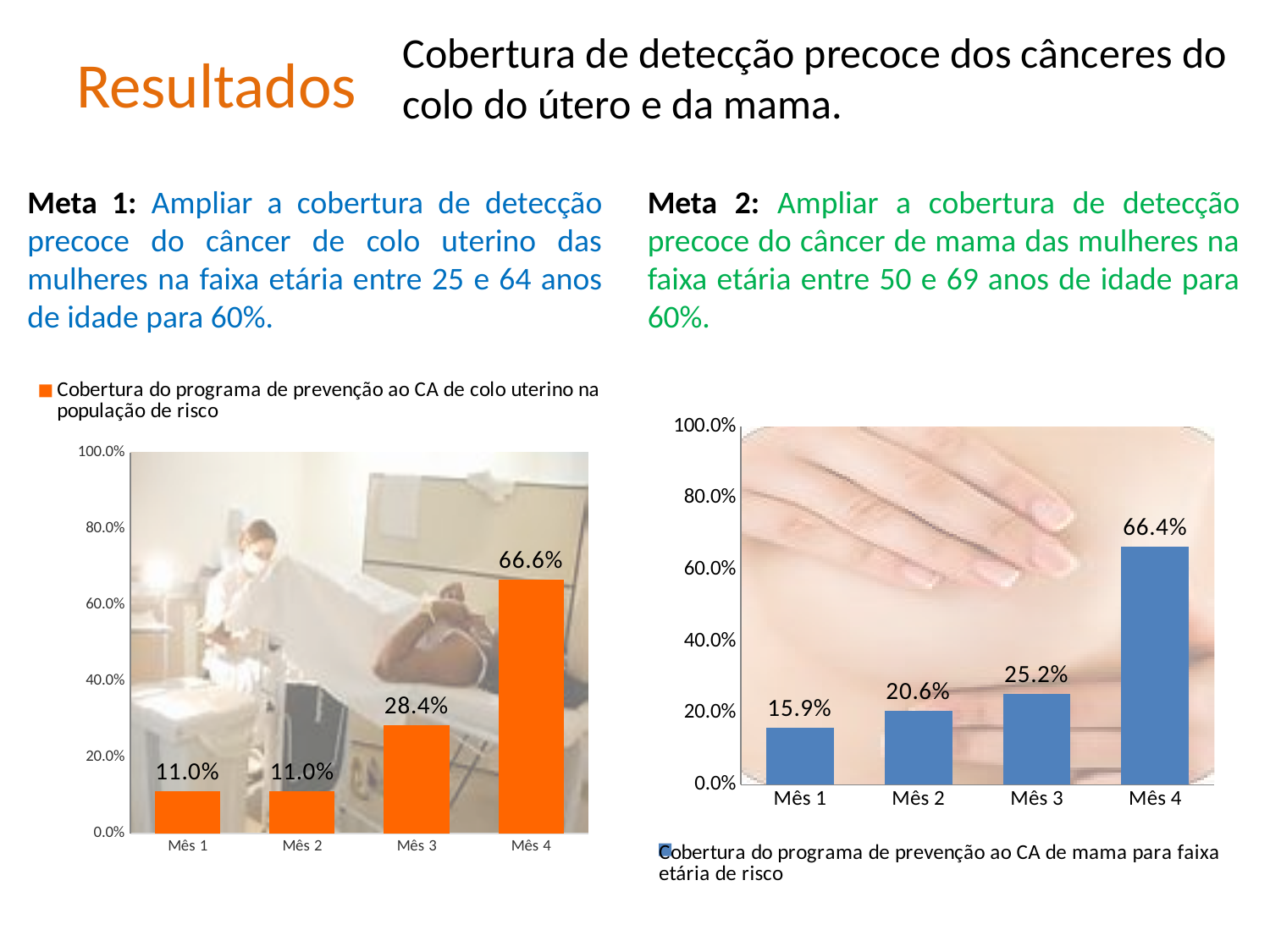
In the left chart (colo uterino), what is the value for Mês 4? 66.6% Which is larger: the Mês 4 value in the left chart (colo uterino) or the Mês 4 value in the right chart (mama)? Left chart (colo uterino), 66.6% How many months are shown on the x axis of the left chart (colo uterino)? 4 In the left chart (colo uterino), what is the difference between the values for Mês 4 and Mês 3? 38.2% In the right chart (mama), what is the value for Mês 3? 25.2% In the right chart (mama), what is the difference between the values for Mês 2 and Mês 1? 4.7% In the right chart (mama), do the values rise or fall from Mês 1 to Mês 4? Rise In the right chart (mama), what is the value for Mês 1? 15.9% In the right chart (mama), which month has the highest value? Mês 4 What type of chart is the right chart (mama)? Bar chart In the right chart (mama), which month has the lowest value? Mês 1 In the left chart (colo uterino), what is the value for Mês 3? 28.4%